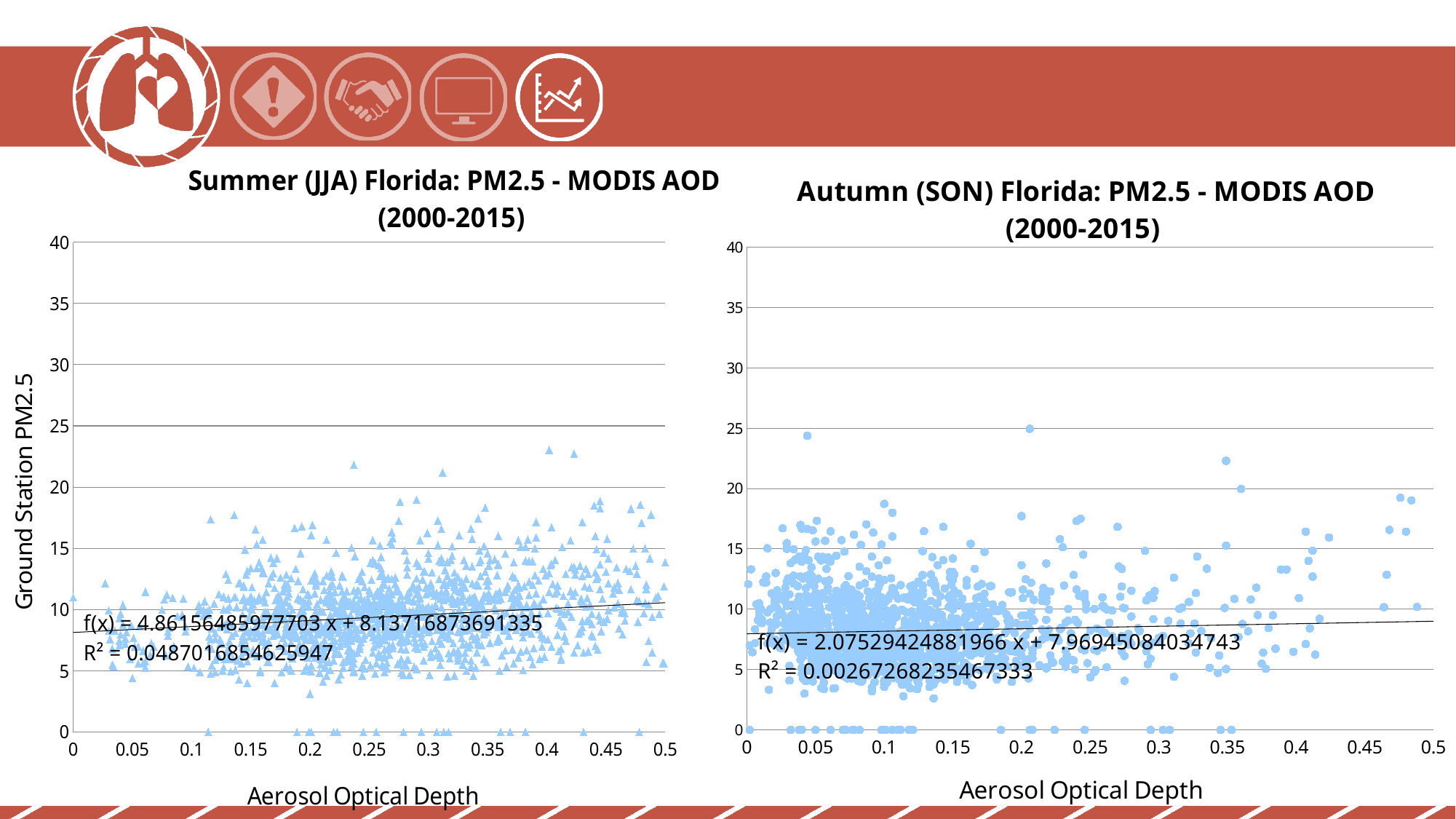
What is the label of the x axis on the Summer (JJA) Florida chart? Aerosol Optical Depth In the Summer (JJA) Florida chart, does the trendline rise or fall as Aerosol Optical Depth increases? rise What is the label of the y axis on the Summer (JJA) Florida chart? Ground Station PM2.5 What kind of chart is the Summer (JJA) Florida chart on the left? scatter chart In the Autumn (SON) Florida chart, what is the R² value shown for the trendline? 0.00267268235467333 In the Summer (JJA) Florida chart, what is the R² value shown for the trendline? 0.0487016854625947 In the Summer (JJA) Florida chart, what is the trendline equation shown? f(x) = 4.86156485977703 x + 8.13716873691335 Which chart has the higher R² value, the Summer (JJA) chart or the Autumn (SON) chart? Summer (JJA) Which chart's trendline has the larger slope, the Summer (JJA) chart or the Autumn (SON) chart? Summer (JJA) In the Autumn (SON) Florida chart, does the trendline rise or fall as Aerosol Optical Depth increases? rise What kind of chart is the Autumn (SON) Florida chart on the right? scatter chart In the Autumn (SON) Florida chart, what is the trendline equation shown? f(x) = 2.07529424881966 x + 7.96945084034743